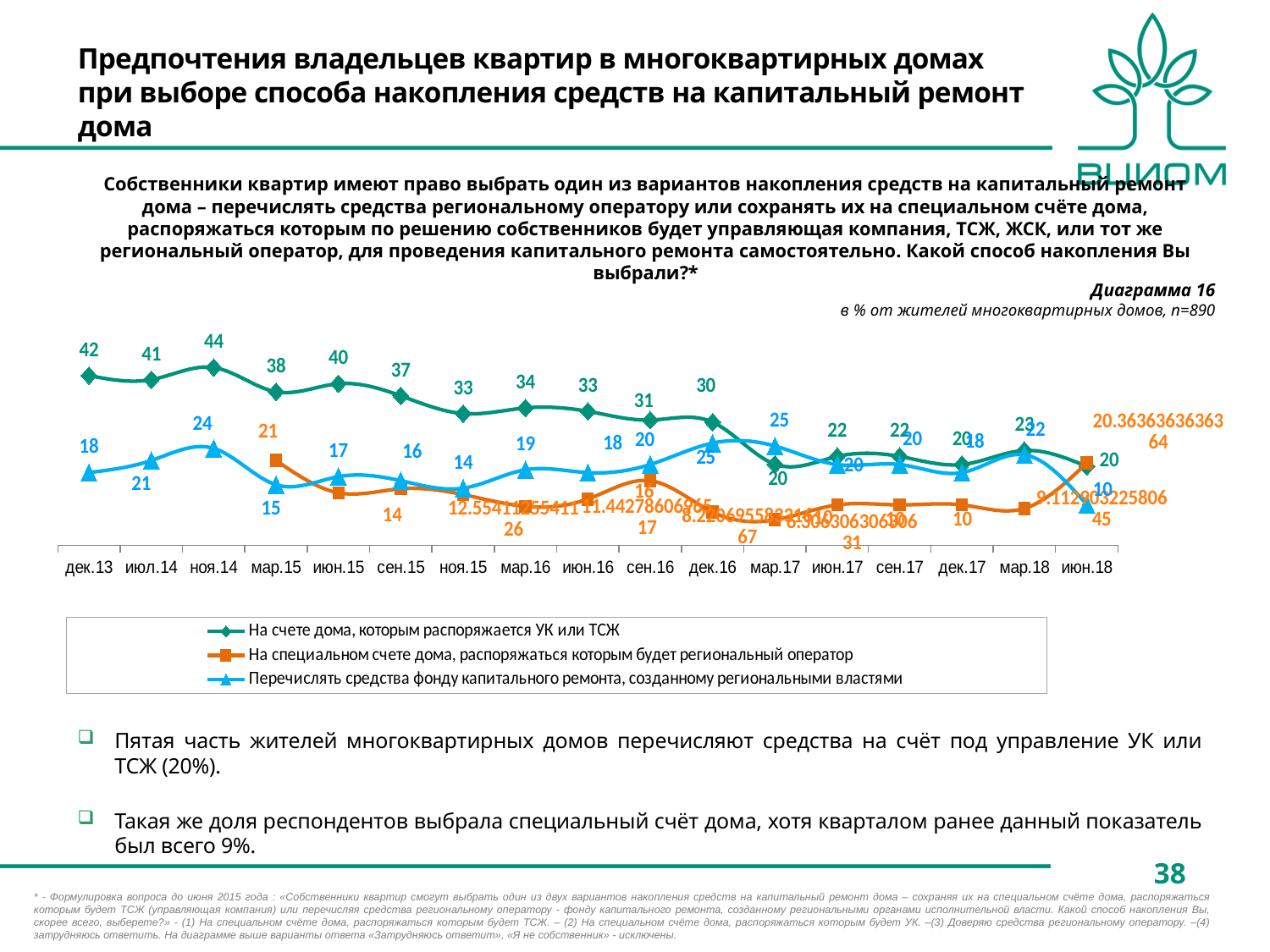
How many time points are shown on the x axis? 17 What diagram number is given for the chart? Диаграмма 16 In дек.13, which is larger: 'На счете дома, которым распоряжается УК или ТСЖ' or 'Перечислять средства фонду капитального ремонта'? На счете дома, которым распоряжается УК или ТСЖ How many series does the legend list? 3 In дек.13, what is the difference between 'На счете дома, которым распоряжается УК или ТСЖ' (42) and 'Перечислять средства фонду капитального ремонта' (18)? 24 What is the value for 'На счете дома, которым распоряжается УК или ТСЖ' in ноя.14? 44 What is the value for 'На счете дома, которым распоряжается УК или ТСЖ' in июн.18? 20 What kind of chart is shown on the slide? line chart In which period does 'Перечислять средства фонду капитального ремонта, созданному региональными властями' have its lowest value? июн.18 What is the value for 'Перечислять средства фонду капитального ремонта, созданному региональными властями' in дек.13? 18 In which period does the series 'На счете дома, которым распоряжается УК или ТСЖ' reach its highest value? ноя.14 Does the series 'На счете дома, которым распоряжается УК или ТСЖ' generally rise or fall from дек.13 to июн.18? fall